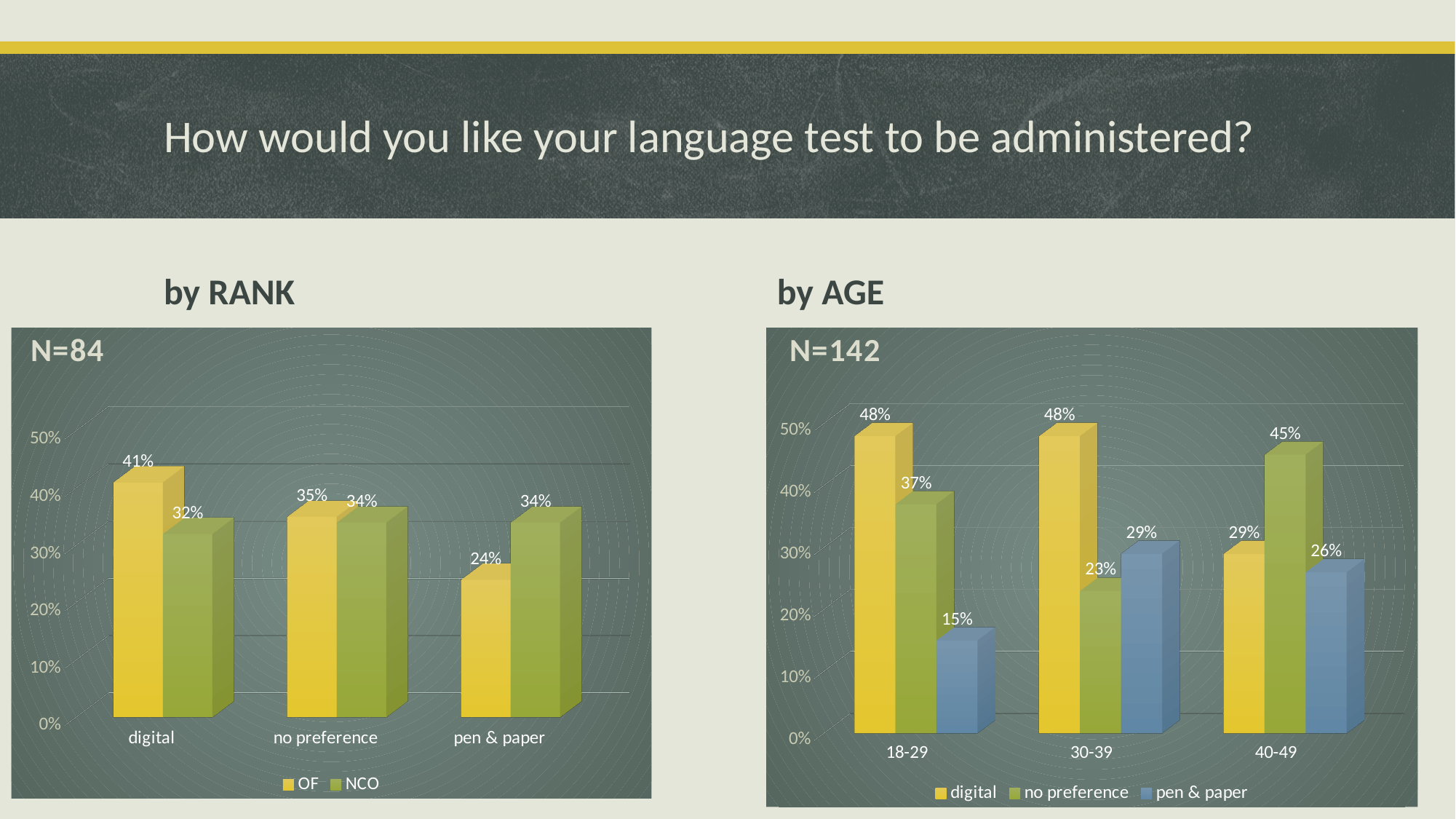
In the 'by RANK' chart, what is the value for NCO in the pen & paper category? 34% In the 'by RANK' chart, which category has the lowest OF value? pen & paper In the 'by AGE' chart, how many age groups are shown on the x axis? 3 In the 'by AGE' chart, what is the value for pen & paper in the 18-29 age group? 15% What kind of chart is the 'by AGE' chart? bar chart In the 'by RANK' chart, what is the difference between the OF and NCO values for digital? 9% In the 'by AGE' chart, is the digital value for 30-39 or the pen & paper value for 30-39 larger? digital In the 'by RANK' chart, how many series does the legend list? 2 In the 'by RANK' chart, what is the value for OF in the digital category? 41% In the 'by AGE' chart, what is the difference between the pen & paper values for 30-39 and 18-29? 14% In the 'by AGE' chart, what is the value for no preference in the 40-49 age group? 45% In the 'by AGE' chart, which age group has the lowest no preference value? 30-39